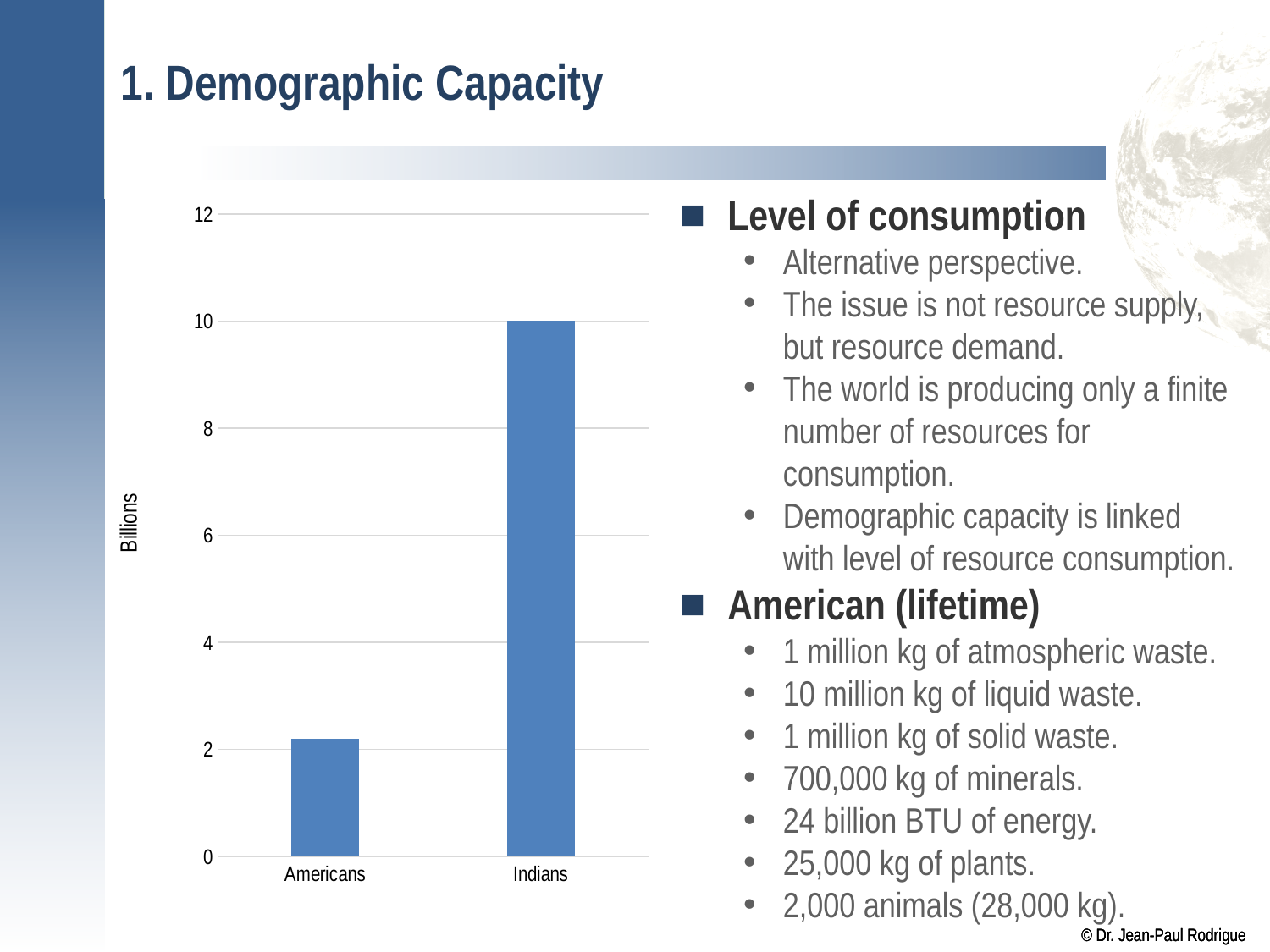
Which category has the highest bar on the chart? Indians Which is larger, the value for Americans or the value for Indians? Indians Is the value for Americans greater or less than 2? greater What is the label on the vertical axis of the chart? Billions What kind of chart is shown on the slide? bar chart Which category has the lowest bar on the chart? Americans Is the value for Americans greater or less than 4? less Is the value for Indians greater or less than 8? greater How many categories are plotted on the chart? 2 What is the value for Indians on the chart? 10 What is the highest value shown on the vertical axis of the chart? 12